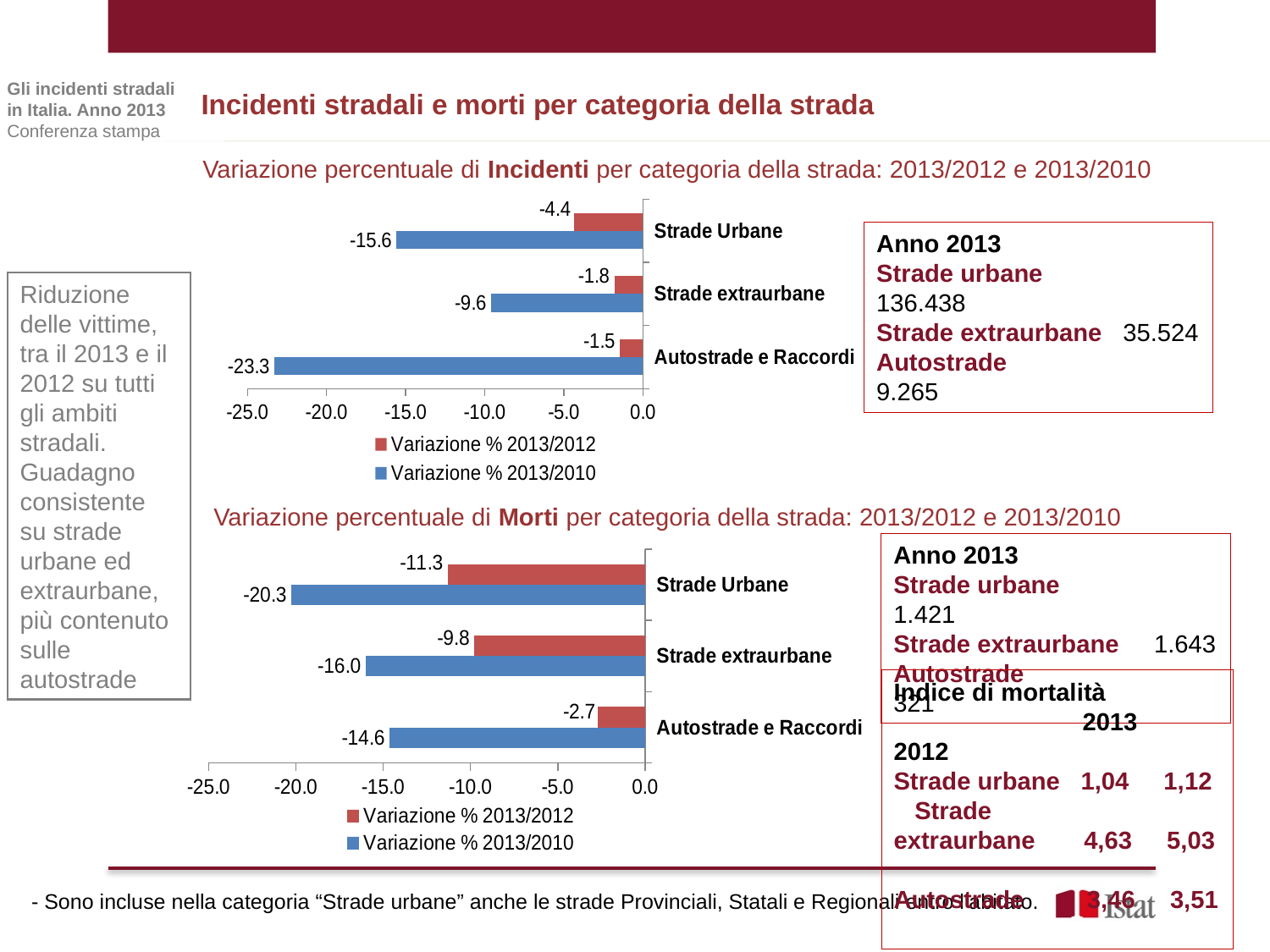
In the 'Variazione percentuale di Morti' chart, what is the Variazione % 2013/2010 value for Strade Urbane? -20.3 In the 'Variazione percentuale di Incidenti' chart, which category has the lowest Variazione % 2013/2010 value? Autostrade e Raccordi How many categories are shown in the 'Variazione percentuale di Morti' chart? 3 In the 'Variazione percentuale di Incidenti' chart, what is the difference between the Variazione % 2013/2010 and Variazione % 2013/2012 values for Strade extraurbane? 7.8 In the 'Variazione percentuale di Morti' chart, which category has the lowest Variazione % 2013/2012 value? Strade Urbane In the 'Variazione percentuale di Morti' chart, which is larger: the Variazione % 2013/2010 value for Strade extraurbane or for Autostrade e Raccordi? Autostrade e Raccordi In the 'Variazione percentuale di Morti' chart, what is the difference between the Variazione % 2013/2010 and Variazione % 2013/2012 values for Autostrade e Raccordi? 11.9 What type of chart is the 'Variazione percentuale di Incidenti' chart? Bar chart In the 'Variazione percentuale di Incidenti' chart, how many series does the legend list? 2 In the 'Variazione percentuale di Incidenti' chart, what is the Variazione % 2013/2010 value for Autostrade e Raccordi? -23.3 In the 'Variazione percentuale di Incidenti' chart, what is the Variazione % 2013/2012 value for Strade Urbane? -4.4 In the 'Variazione percentuale di Morti' chart, what is the Variazione % 2013/2012 value for Strade extraurbane? -9.8